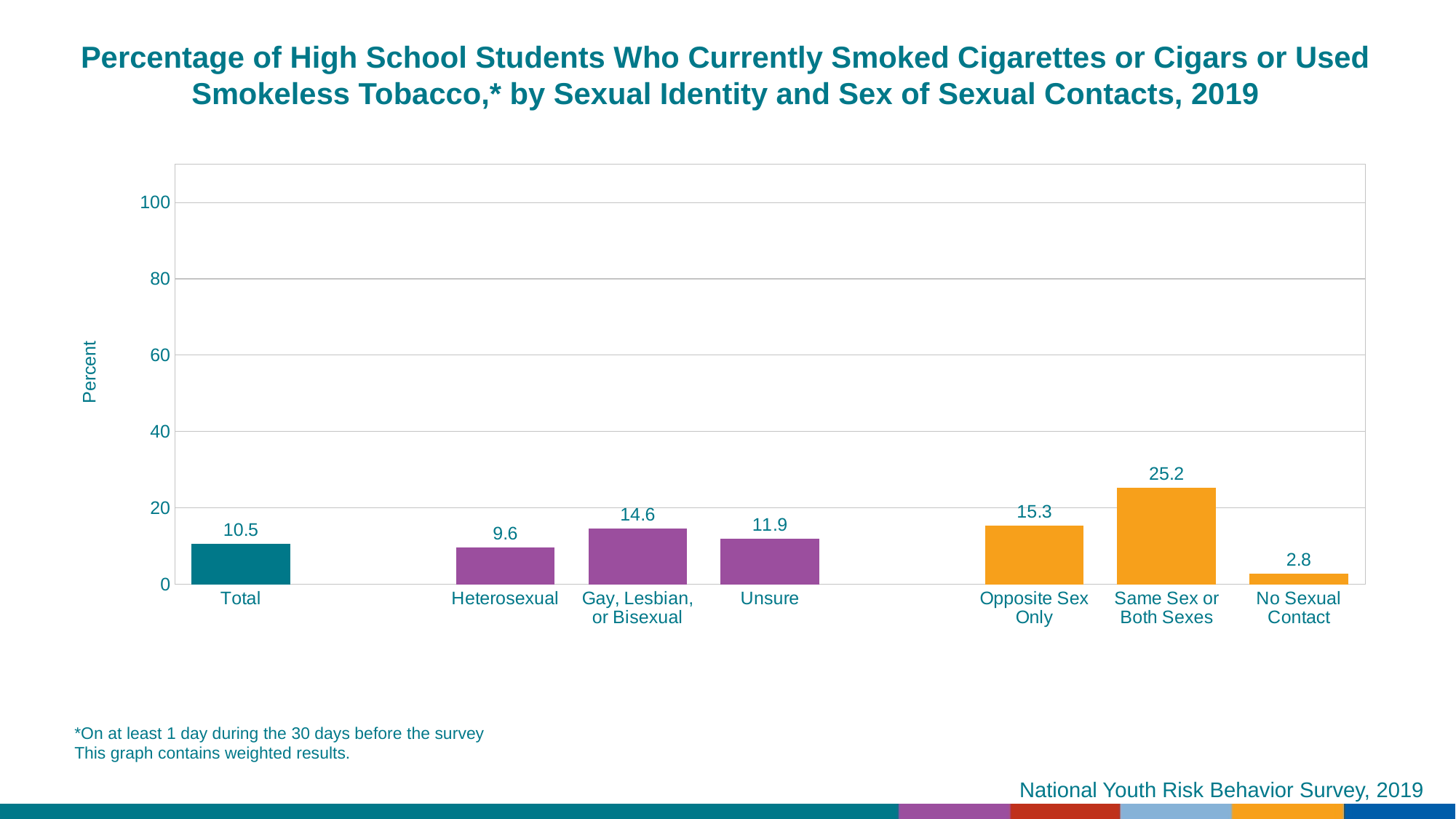
What is the value for Same Sex or Both Sexes? 25.2 What is the value for No Sexual Contact? 2.8 Which category has the lowest value? No Sexual Contact What is the value for Total? 10.5 Which category has the highest value? Same Sex or Both Sexes Is the value for Same Sex or Both Sexes greater or less than 20? greater What is the difference between the values for Same Sex or Both Sexes and Opposite Sex Only? 9.9 What kind of chart is shown on the slide? Bar chart Which is larger, the value for Unsure or the value for Heterosexual? Unsure How many categories are shown on the x axis? 7 What is the value for Gay, Lesbian, or Bisexual? 14.6 What is the difference between the values for Gay, Lesbian, or Bisexual and Heterosexual? 5.0